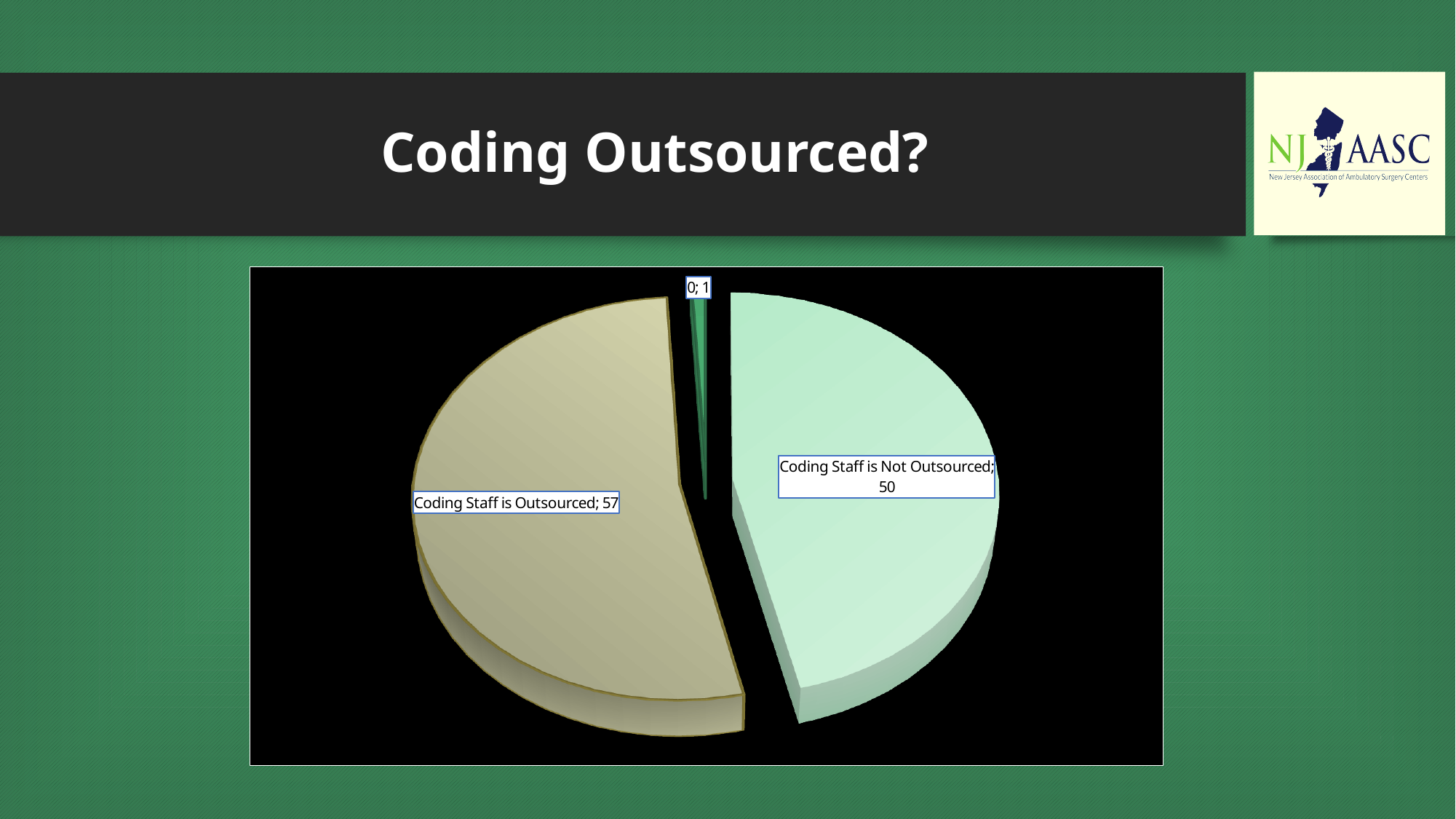
What is the title of the slide containing the chart? Coding Outsourced? What is the value for "Coding Staff is Outsourced"? 57 What kind of chart is shown on the slide? pie chart Which slice of the pie is the smallest? 0 Which slice of the pie is the largest? Coding Staff is Outsourced Which is larger, "Coding Staff is Outsourced" or "Coding Staff is Not Outsourced"? Coding Staff is Outsourced What is the difference between the values for "Coding Staff is Outsourced" and "Coding Staff is Not Outsourced"? 7 What is the value of the small slice labelled "0"? 1 What share of the pie does "Coding Staff is Outsourced" represent, to the nearest whole percent? 53% What is the total of all the slice values in the pie chart? 108 How many slices does the pie chart have? 3 What is the value for "Coding Staff is Not Outsourced"? 50